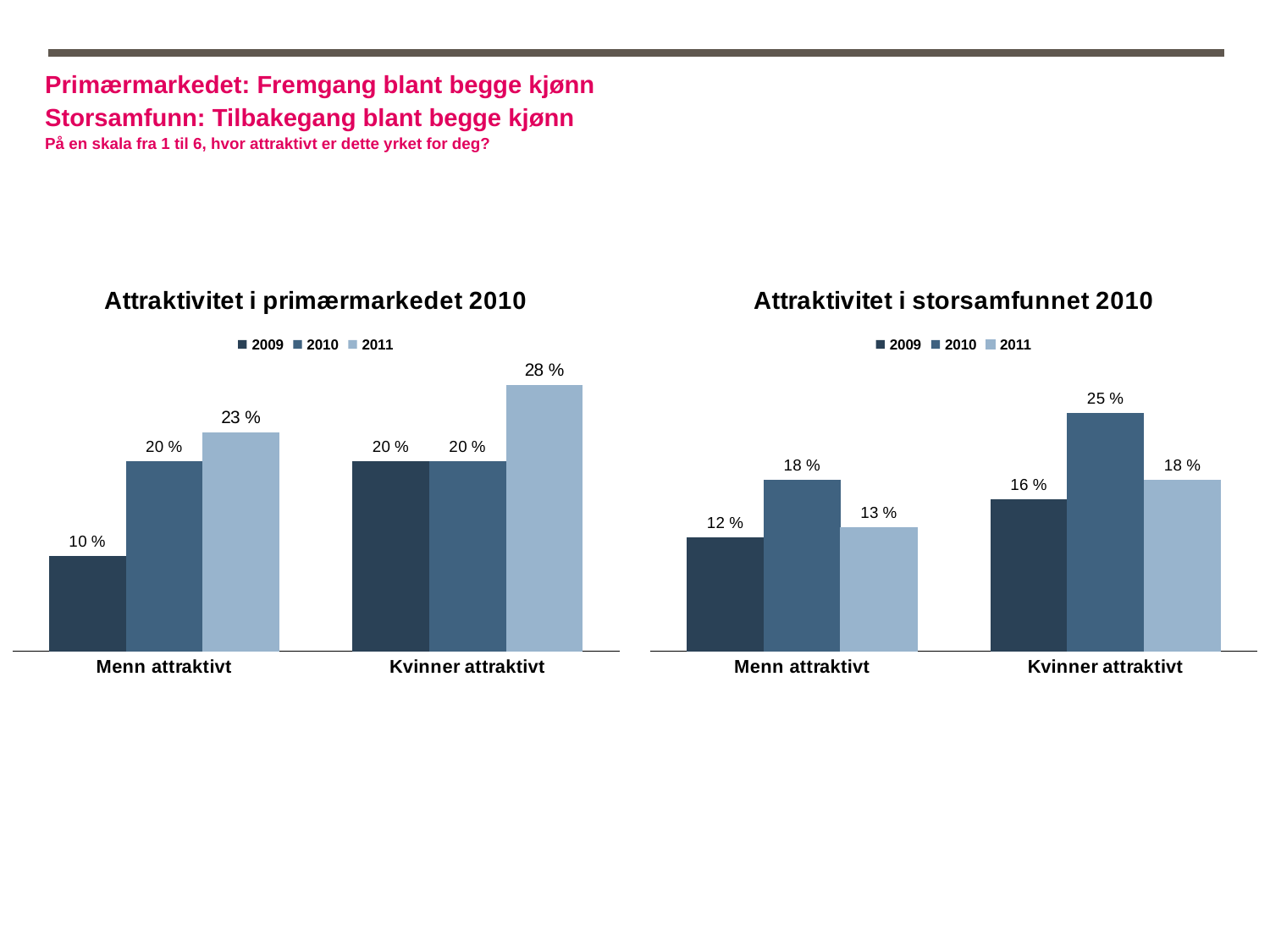
In the chart 'Attraktivitet i primærmarkedet 2010', what is the value for 2011 in the 'Kvinner attraktivt' group? 28 % In the chart 'Attraktivitet i storsamfunnet 2010', which is larger: the 2010 value for 'Menn attraktivt' or the 2009 value for 'Kvinner attraktivt'? 2010 value for Menn attraktivt In the chart 'Attraktivitet i storsamfunnet 2010', what is the value for 2011 in the 'Menn attraktivt' group? 13 % In the chart 'Attraktivitet i storsamfunnet 2010', what is the value for 2010 in the 'Kvinner attraktivt' group? 25 % How many series does the legend list in the chart 'Attraktivitet i primærmarkedet 2010'? 3 In the chart 'Attraktivitet i primærmarkedet 2010', what is the value for 2009 in the 'Menn attraktivt' group? 10 % In the chart 'Attraktivitet i storsamfunnet 2010', what is the difference between the 2010 and 2011 values for 'Kvinner attraktivt'? 7 % What kind of chart is 'Attraktivitet i storsamfunnet 2010'? Bar chart In the chart 'Attraktivitet i storsamfunnet 2010', which year has the lowest value in the 'Menn attraktivt' group? 2009 In the chart 'Attraktivitet i primærmarkedet 2010', which year has the highest value in the 'Kvinner attraktivt' group? 2011 In the chart 'Attraktivitet i storsamfunnet 2010', do the values for 'Menn attraktivt' rise or fall from 2010 to 2011? Fall In the chart 'Attraktivitet i primærmarkedet 2010', what is the difference between the 2011 and 2009 values for 'Menn attraktivt'? 13 %